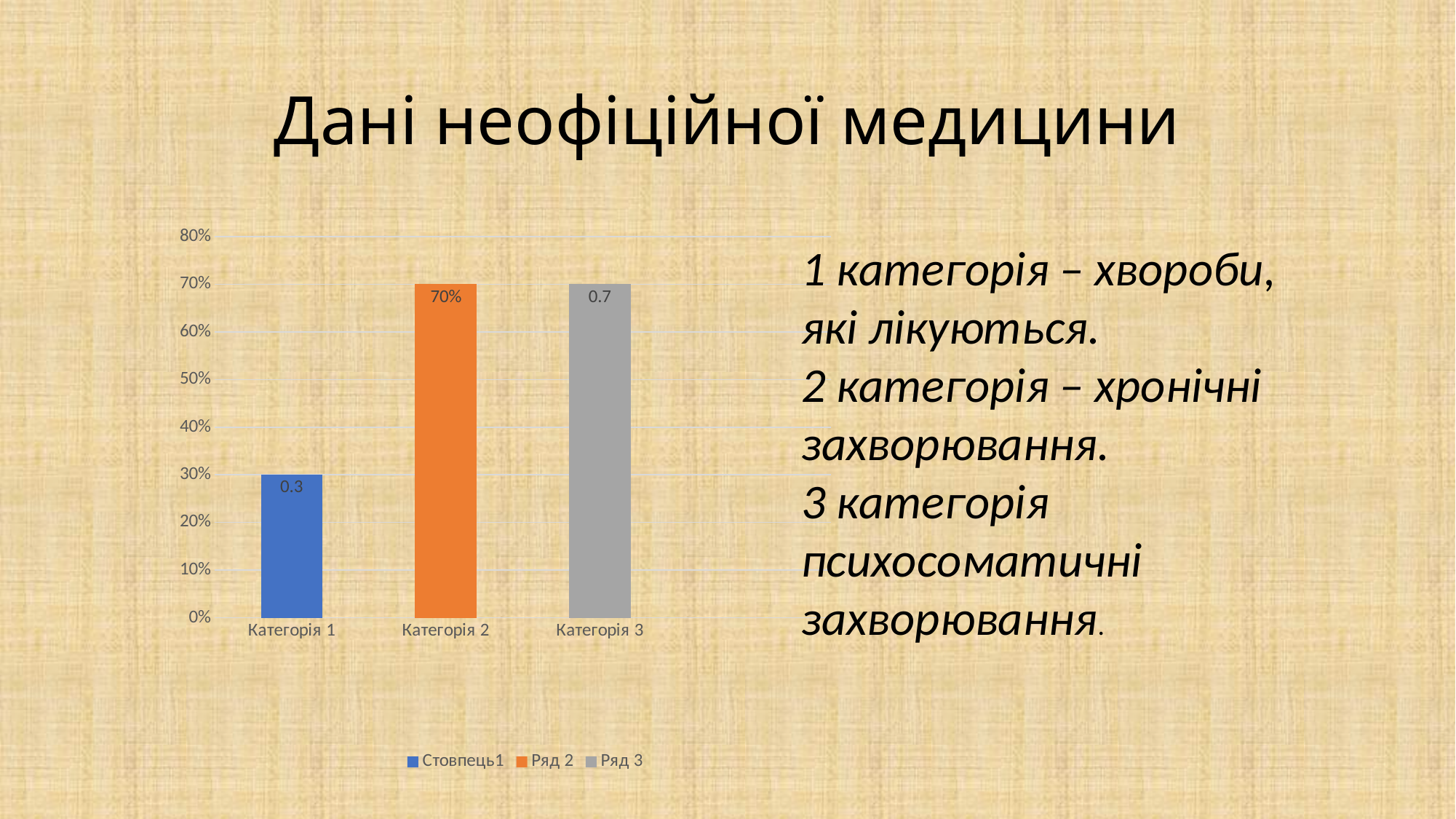
Which category has the lowest bar? Категорія 1 What colour is the bar for Категорія 2? orange Is the value for Категорія 1 greater or less than 50%? less How many series does the legend list? 3 What kind of chart is shown on the slide? bar chart How many categories are shown on the x axis? 3 Is the value for Категорія 3 greater or less than 60%? greater What is the data label shown on the bar for Категорія 1? 0.3 What is the difference between the labelled values for Категорія 3 and Категорія 1? 0.4 What is the data label shown on the bar for Категорія 2? 70% Which is larger, the value for Категорія 1 or the value for Категорія 2? Категорія 2 What is the data label shown on the bar for Категорія 3? 0.7